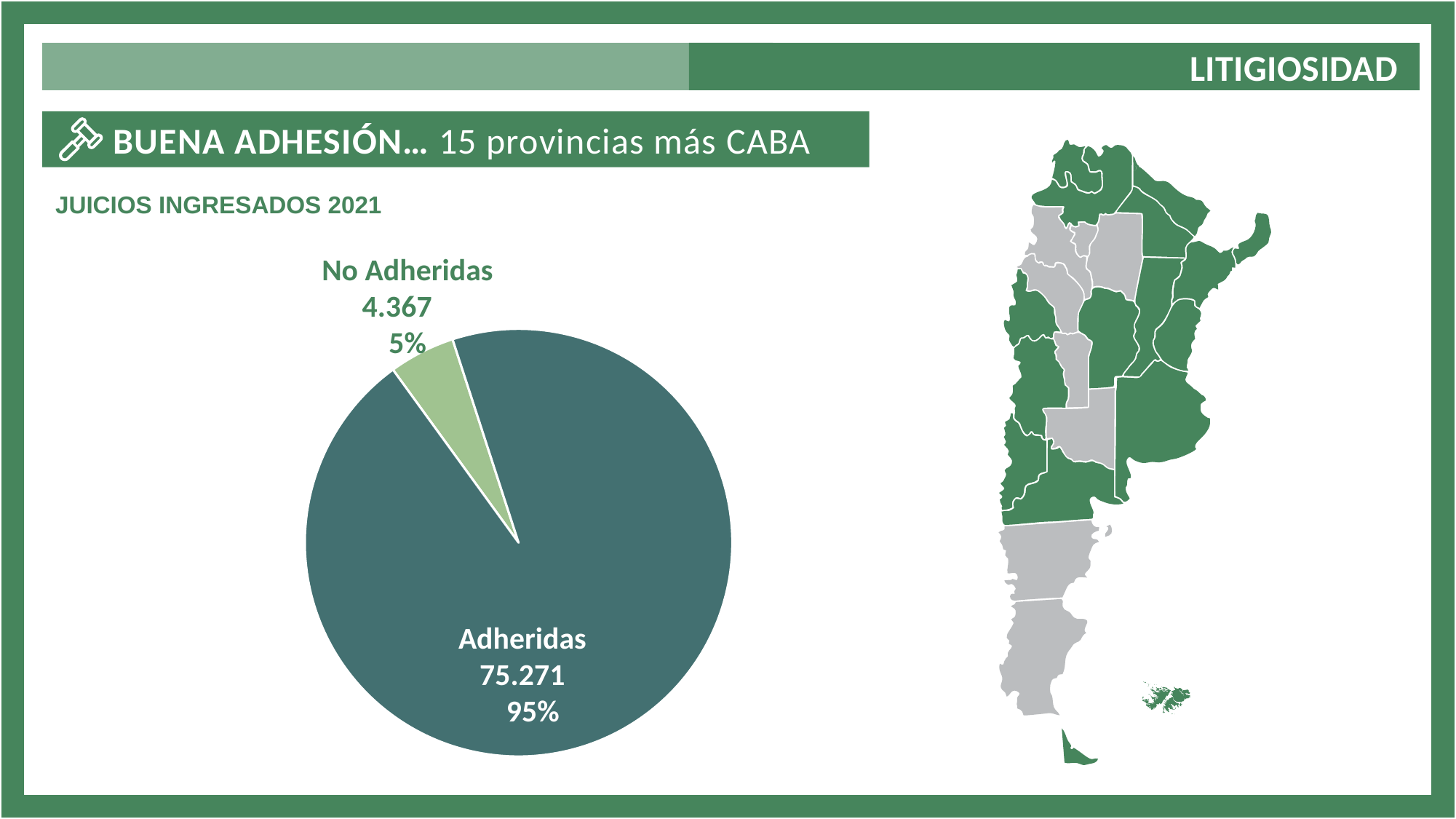
What is the title of the pie chart? JUICIOS INGRESADOS 2021 How many slices does the pie chart have? 2 What is the difference between the Adheridas and No Adheridas values? 70.904 Which slice of the pie chart is the smallest? No Adheridas What share of the pie does the Adheridas slice represent? 95% What colour is the No Adheridas slice? light green What kind of chart is shown on the slide? pie chart What share of the pie does the No Adheridas slice represent? 5% Which is larger, Adheridas or No Adheridas? Adheridas What is the value for Adheridas in the pie chart? 75.271 Which slice of the pie chart is the largest? Adheridas What is the value for No Adheridas in the pie chart? 4.367